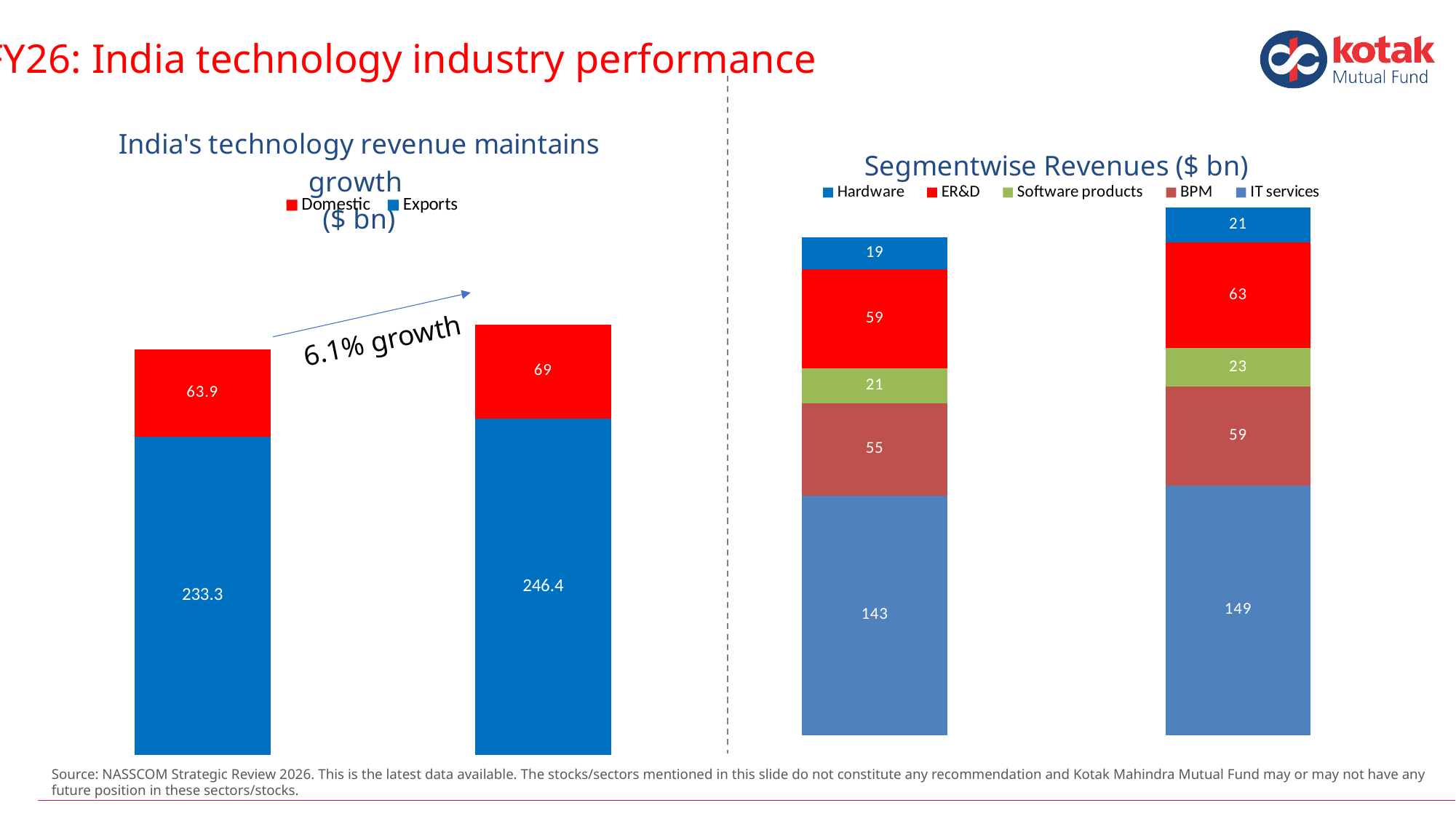
In the left chart, 'India's technology revenue maintains growth ($ bn)', what is the Exports value for the left bar? 233.3 In the left chart, 'India's technology revenue maintains growth ($ bn)', how many series does the legend list? 2 In the right chart, 'Segmentwise Revenues ($ bn)', which segment is the largest in the left bar? IT services In the right chart, 'Segmentwise Revenues ($ bn)', what is the ER&D value for the left bar? 59 What kind of chart is the right chart, 'Segmentwise Revenues ($ bn)'? Stacked bar chart In the right chart, 'Segmentwise Revenues ($ bn)', what is the IT services value for the right bar? 149 In the left chart, 'India's technology revenue maintains growth ($ bn)', what is the Domestic value for the right bar? 69 In the right chart, 'Segmentwise Revenues ($ bn)', how many series does the legend list? 5 In the left chart, 'India's technology revenue maintains growth ($ bn)', what is the total of the right stacked bar? 315.4 In the right chart, 'Segmentwise Revenues ($ bn)', what is the difference between the IT services values of the right bar and the left bar? 6 In the left chart, 'India's technology revenue maintains growth ($ bn)', what growth percentage is annotated between the two bars? 6.1% growth In the right chart, 'Segmentwise Revenues ($ bn)', what is the total of the left stacked bar? 297